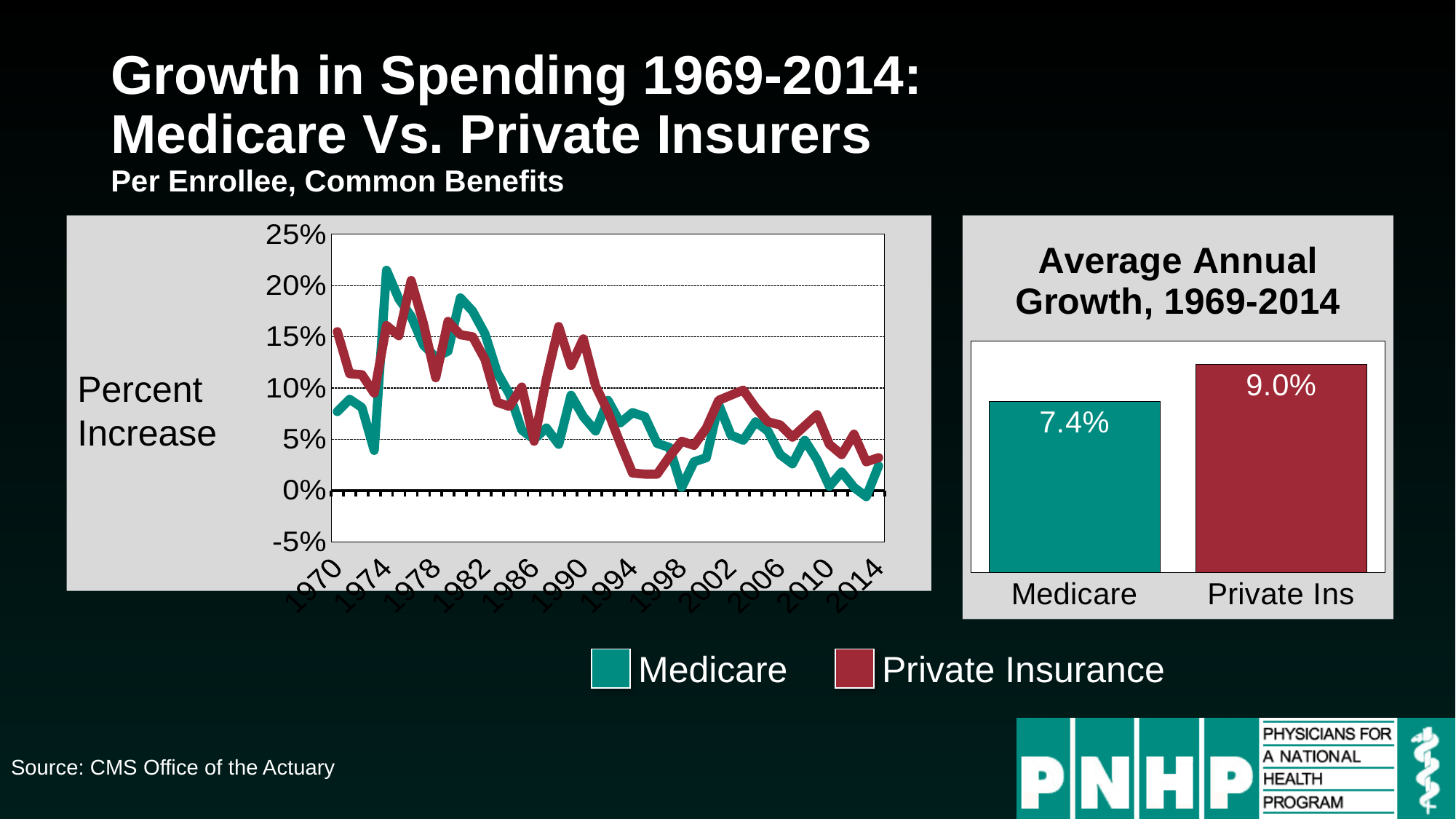
In the 'Average Annual Growth, 1969-2014' bar chart, what is the value for Medicare? 7.4% In the 'Percent Increase' line chart on the left, do the values generally rise or fall from 1970 to 2014? Fall What kind of chart is the 'Percent Increase' chart on the left? Line chart In the 'Percent Increase' line chart on the left, which colour represents Private Insurance? Red How many series does the legend list for the 'Percent Increase' line chart on the left? 2 In the 'Average Annual Growth, 1969-2014' bar chart, which category has the lower value? Medicare In the 'Average Annual Growth, 1969-2014' bar chart, how many bars are shown? 2 In the 'Percent Increase' line chart on the left, is the Medicare value for 1974 greater or less than 20%? greater What kind of chart is the 'Average Annual Growth, 1969-2014' chart on the right? Bar chart In the 'Average Annual Growth, 1969-2014' bar chart, which category has the higher value? Private Ins In the 'Average Annual Growth, 1969-2014' bar chart, what is the value for Private Ins? 9.0% In the 'Average Annual Growth, 1969-2014' bar chart, what is the difference between the Private Ins value and the Medicare value? 1.6%